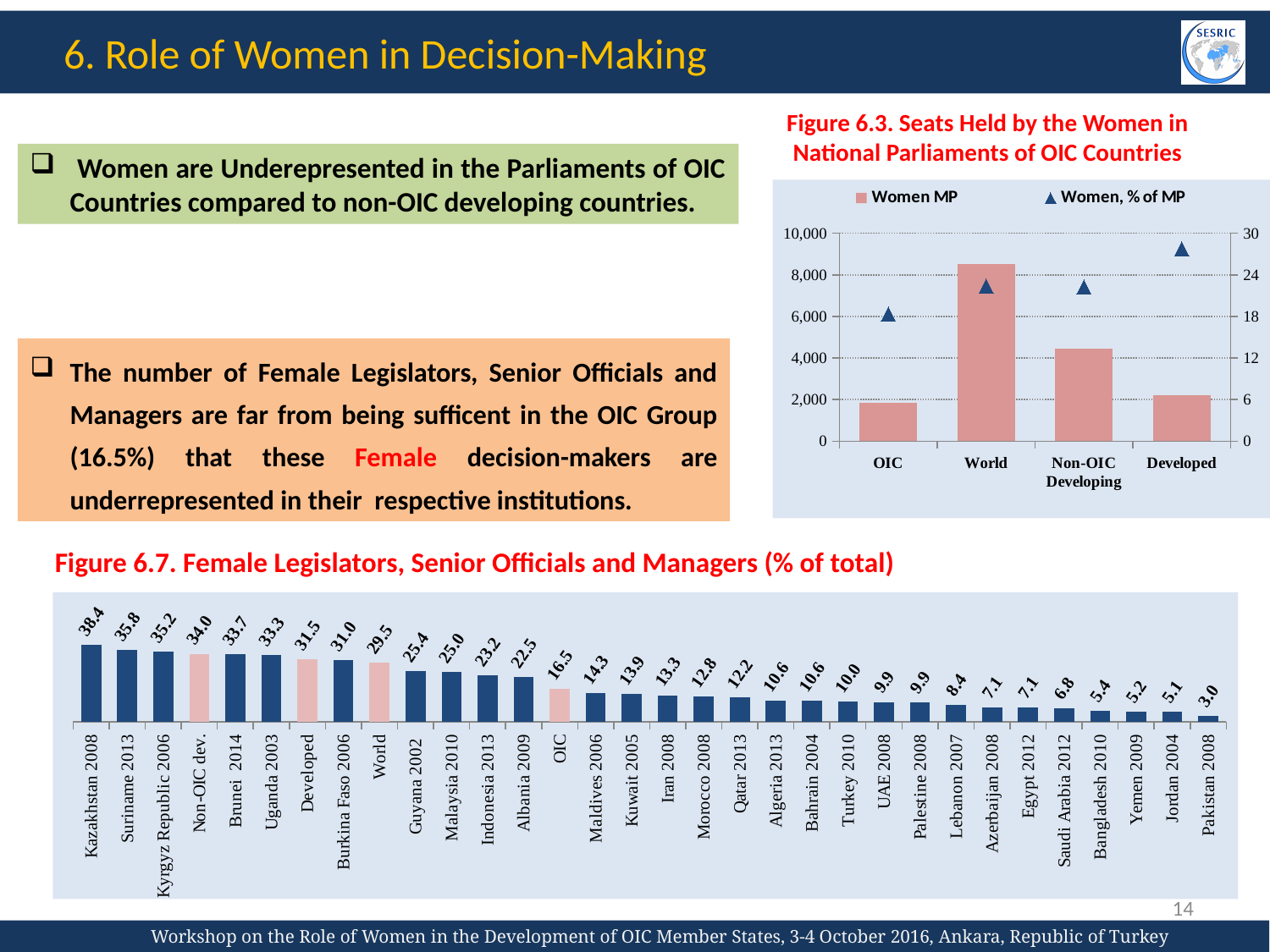
In Figure 6.7, which category has the highest value? Kazakhstan 2008 In Figure 6.7, what is the difference between the Non-OIC dev. value and the OIC value? 17.5 In Figure 6.7, what is the value for the OIC group? 16.5 In Figure 6.3, is the Women MP value for World greater or less than 8,000? greater In Figure 6.3, which category has the highest Women MP bar? World In Figure 6.7, what is the value for Kazakhstan 2008? 38.4 In Figure 6.3, how many series does the legend list? 2 In Figure 6.3, is the Women MP value for OIC greater or less than 2,000? less In Figure 6.7, which is larger, the value for Turkey 2010 or the value for Malaysia 2010? Malaysia 2010 In Figure 6.7, how many categories are plotted? 32 In Figure 6.7, which category has the lowest value? Pakistan 2008 What kind of chart is Figure 6.7? Bar chart